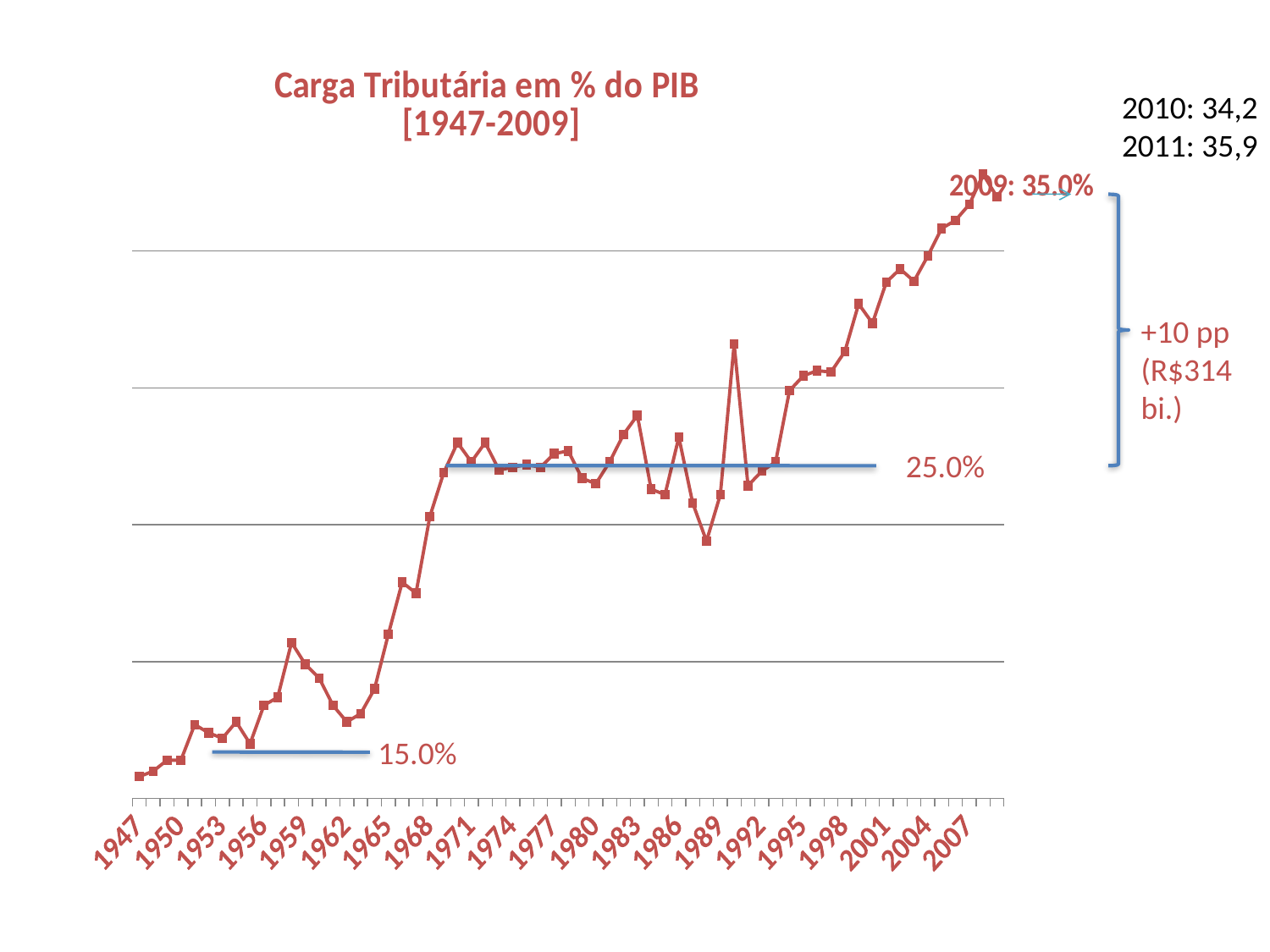
What kind of chart is shown on the slide? line chart Is the value for 2007 greater or less than the 25.0% reference line? greater Overall, do the values rise or fall from 1947 to 2009? rise Which year has the lowest value on the chart? 1947 What value is labelled for 2009 on the chart? 35.0% Which year has the larger value, 1965 or 1970? 1970 How many data series are plotted on the chart? 1 Which year has the larger value, 1989 or 1990? 1990 Is the value for 1965 greater or less than the 25.0% reference line? less Is the value for 1947 greater or less than the 15.0% reference line? less What increase in percentage points is indicated by the bracket annotation on the right of the chart? +10 pp (R$314 bi.) What is the title of the chart? Carga Tributária em % do PIB [1947-2009]